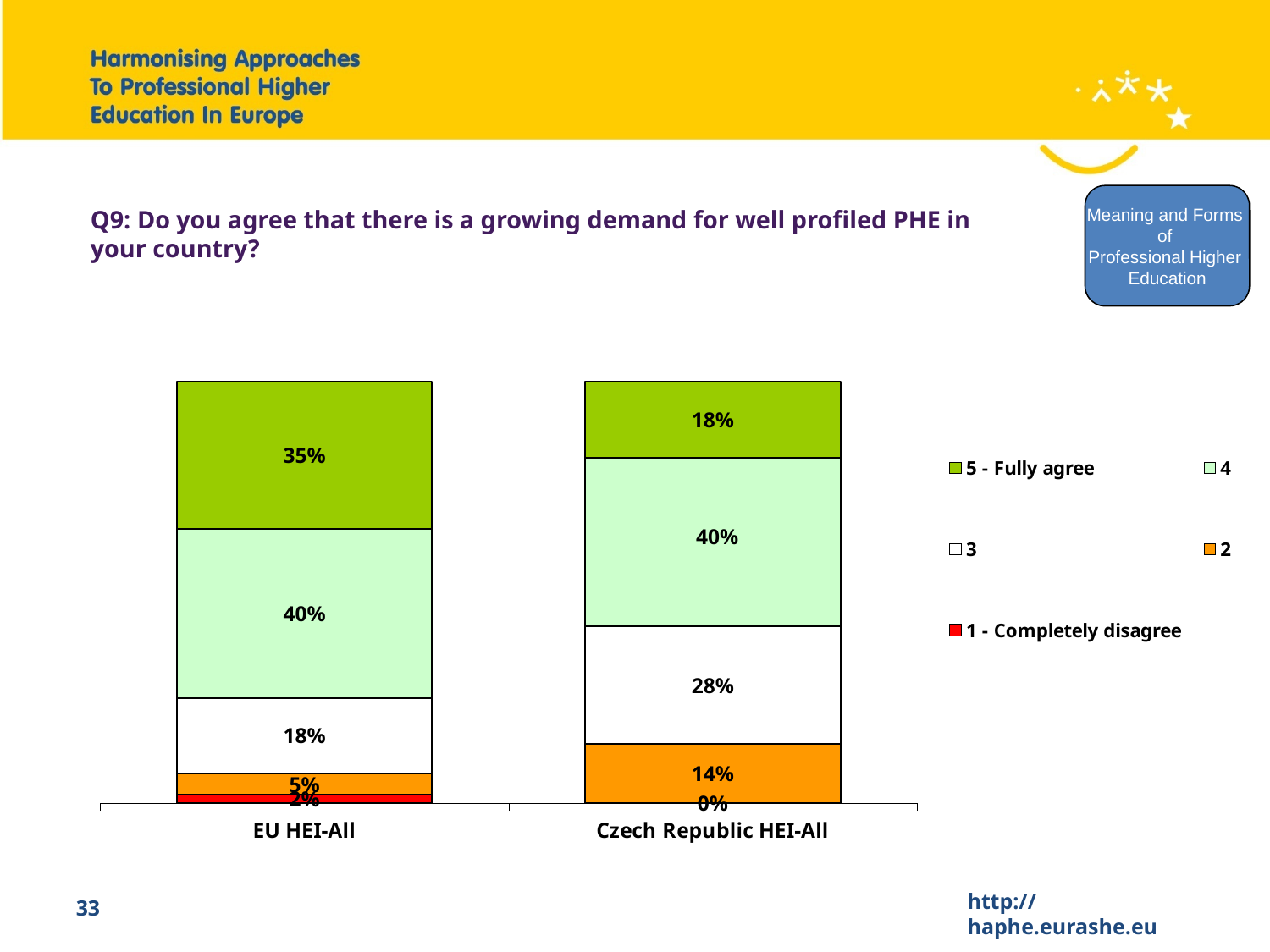
What is the difference between the '5 - Fully agree' values for EU HEI-All and Czech Republic HEI-All? 17% Which legend entry is shown in red? 1 - Completely disagree What is the value of the '5 - Fully agree' segment for EU HEI-All? 35% What kind of chart is shown on the slide? bar chart How many categories are shown on the x axis of the chart? 2 What is the value of the '4' segment for EU HEI-All? 40% Which category has the larger '3' segment, EU HEI-All or Czech Republic HEI-All? Czech Republic HEI-All What is the value of the '3' segment for Czech Republic HEI-All? 28% Which series has the largest segment in the Czech Republic HEI-All bar? 4 What is the value of the '2' segment for Czech Republic HEI-All? 14% What is the value of the '1 - Completely disagree' segment for Czech Republic HEI-All? 0% How many series does the chart's legend list? 5